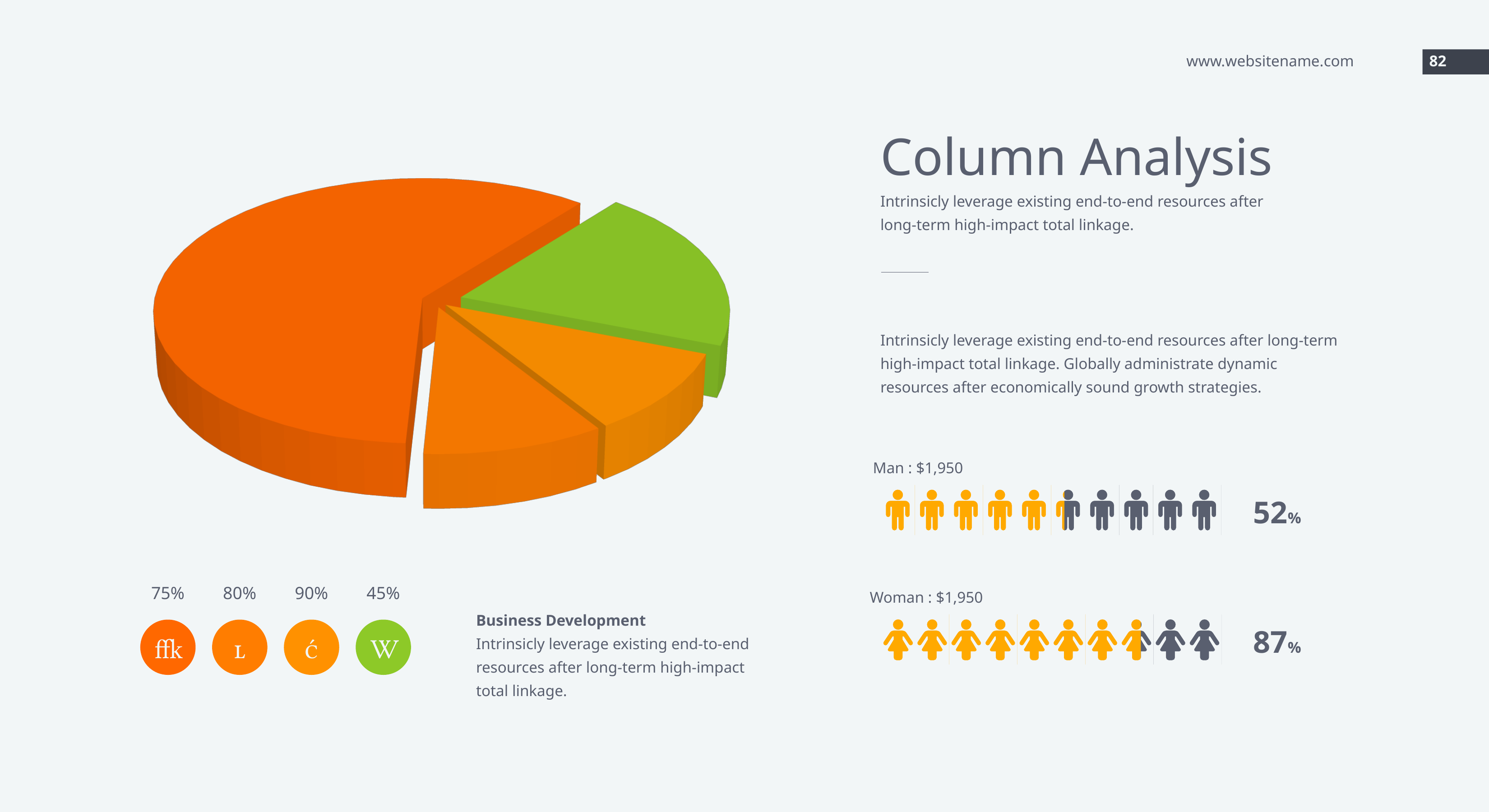
Is the pie chart drawn in 3D? yes In the pictograph on the right, what percentage is shown for Man? 52% In the pictograph on the right, how many person icons are in the Woman row? 10 In the pictograph on the right, what dollar value is shown next to Man? $1,950 What colour is the only non-orange slice in the pie chart? green In the pictograph on the right, which has the higher percentage, Man or Woman? Woman What kind of chart is shown on the left side of the slide? pie chart Which slice of the pie chart is the largest? the dark orange slice In the pictograph on the right, what is the difference between the Woman percentage and the Man percentage? 35 percentage points In the pictograph on the right, what percentage is shown for Woman? 87% How many slices does the pie chart have? 4 In the pictograph on the right, is the Man percentage greater or less than 50%? greater